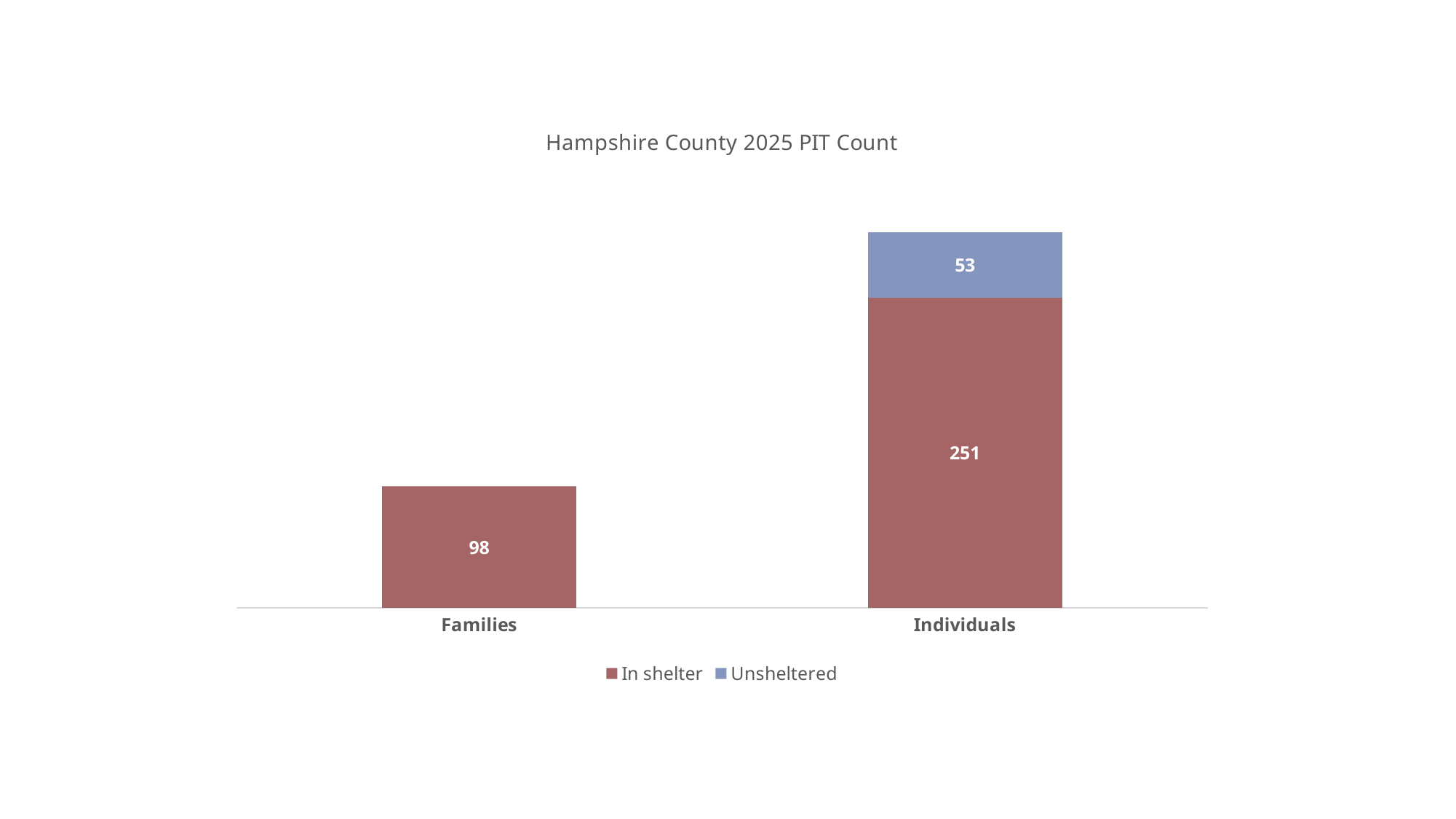
What is the Unsheltered value for Individuals? 53 What kind of chart is shown on the slide? stacked bar chart What is the In shelter value for Families? 98 Is the In shelter value for Individuals larger or smaller than the Unsheltered value for Individuals? larger What is the difference between the In shelter values for Individuals and Families? 153 What is the In shelter value for Individuals? 251 Which category has the higher In shelter value? Individuals How many series does the legend list? 2 What is the title of the chart? Hampshire County 2025 PIT Count How many categories are shown on the x axis? 2 What is the total of the stacked bar for Individuals? 304 Which category has the lower In shelter value? Families